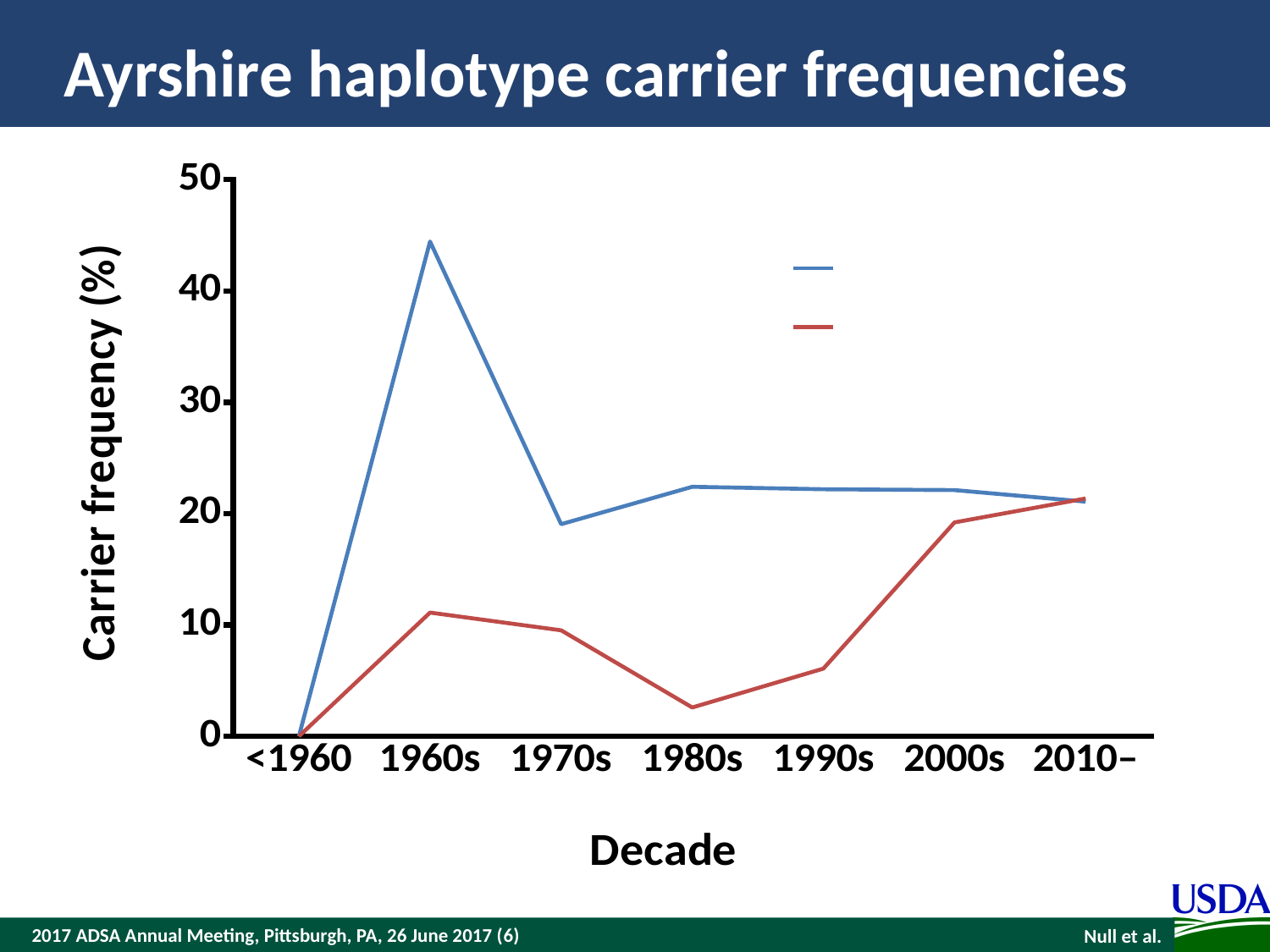
Does the red line rise or fall from the 1980s to 2010–? rise Is the carrier frequency of the red line in the 1980s greater or less than 10? less In which decade does the blue line reach its highest carrier frequency? 1960s Is the carrier frequency of the blue line in the 1980s greater or less than 20? greater How many decade categories are shown on the x axis? 7 In the 1990s, which line has the higher carrier frequency, the blue line or the red line? blue line What is the carrier frequency of the blue line at <1960? 0 In which decade is the red line at its lowest carrier frequency? <1960 What kind of chart is shown on the slide? line chart How many series (lines) are plotted on the chart? 2 Is the carrier frequency of the blue line in the 1960s greater or less than 40? greater What is the title of the y axis? Carrier frequency (%)